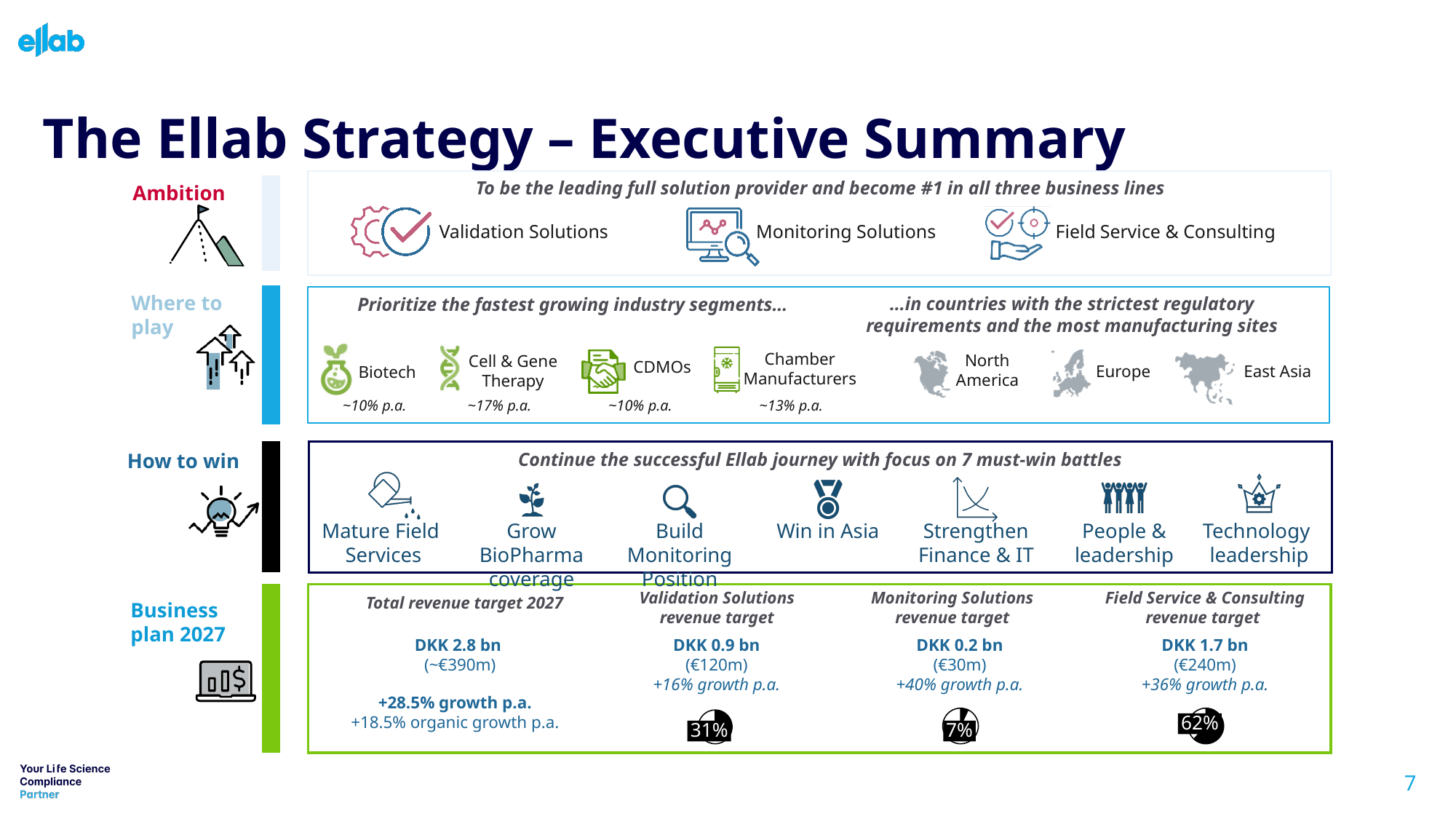
What kind of chart is used to show the revenue shares in the Business plan 2027 section? pie chart Which business line's pie chart in the Business plan 2027 section shows the smallest share? Monitoring Solutions Which business line's pie chart in the Business plan 2027 section shows the largest share? Field Service & Consulting What share is shown in the pie chart under the Field Service & Consulting revenue target? 62% Is the share shown in the Monitoring Solutions pie chart greater or less than 10%? less Is the share in the Field Service & Consulting pie chart larger or smaller than the share in the Validation Solutions pie chart? larger What is the difference in percentage points between the Validation Solutions pie chart share and the Monitoring Solutions pie chart share? 24 What share is shown in the pie chart under the Validation Solutions revenue target? 31% How many pie charts are shown in the Business plan 2027 section? 3 What is the difference in percentage points between the Field Service & Consulting pie chart share and the Validation Solutions pie chart share? 31 Is the share shown in the Field Service & Consulting pie chart greater or less than 50%? greater What share is shown in the pie chart under the Monitoring Solutions revenue target? 7%